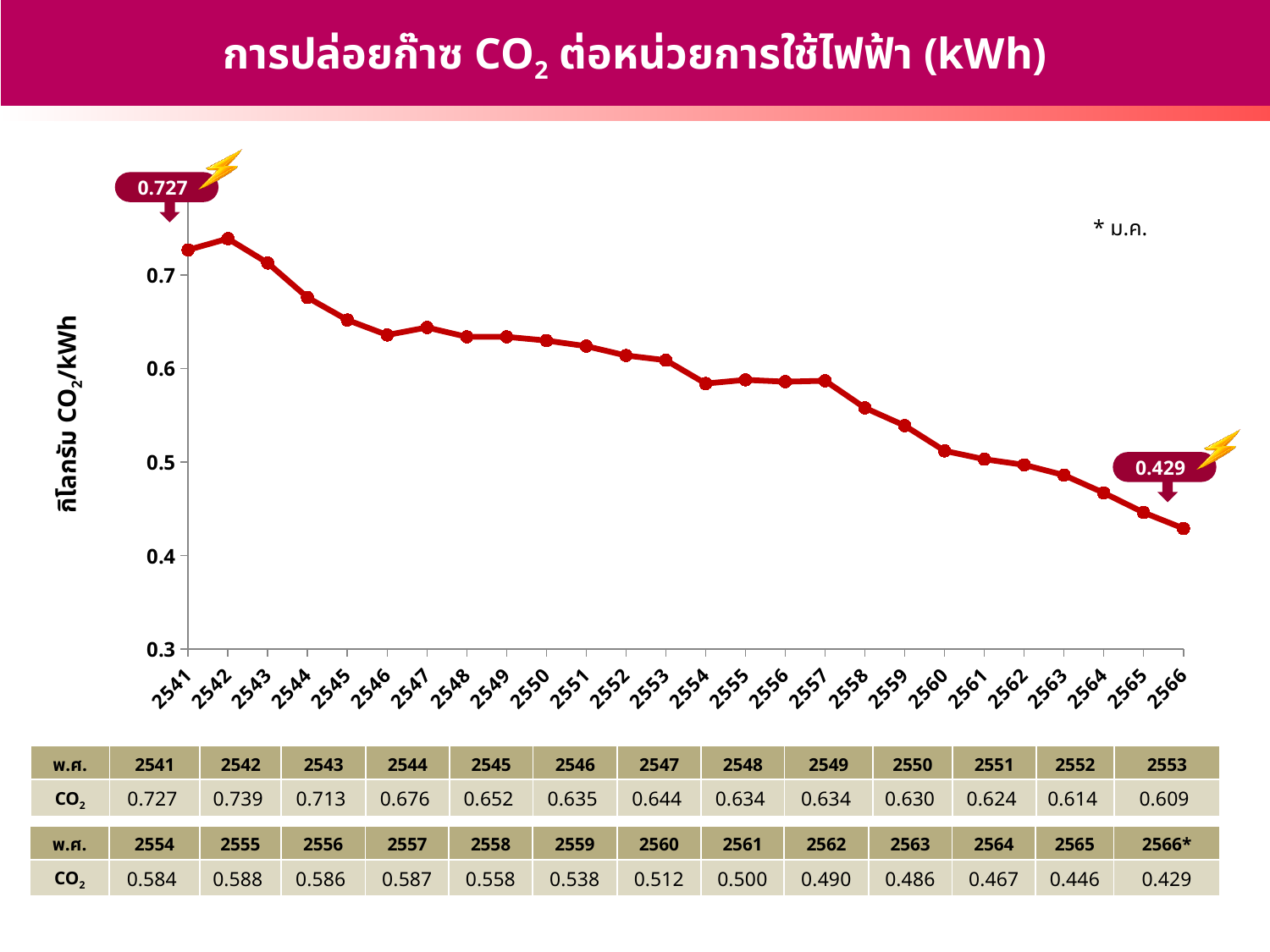
What type of chart is shown on the slide? line chart What is the label on the vertical axis of the chart? กิโลกรัม CO2/kWh Which year has a larger CO2 value, 2544 or 2560? 2544 How many years are plotted on the chart? 26 What is the CO2 emission value for the year 2541? 0.727 What is the CO2 emission value for the year 2566? 0.429 Which year has the highest CO2 emission value? 2542 What is the difference between the CO2 values for 2541 and 2566? 0.298 What is the CO2 emission value for the year 2557? 0.587 Is the value for 2550 greater or less than 0.6? greater Do the values generally rise or fall from 2541 to 2566? fall Which year has the lowest CO2 emission value? 2566